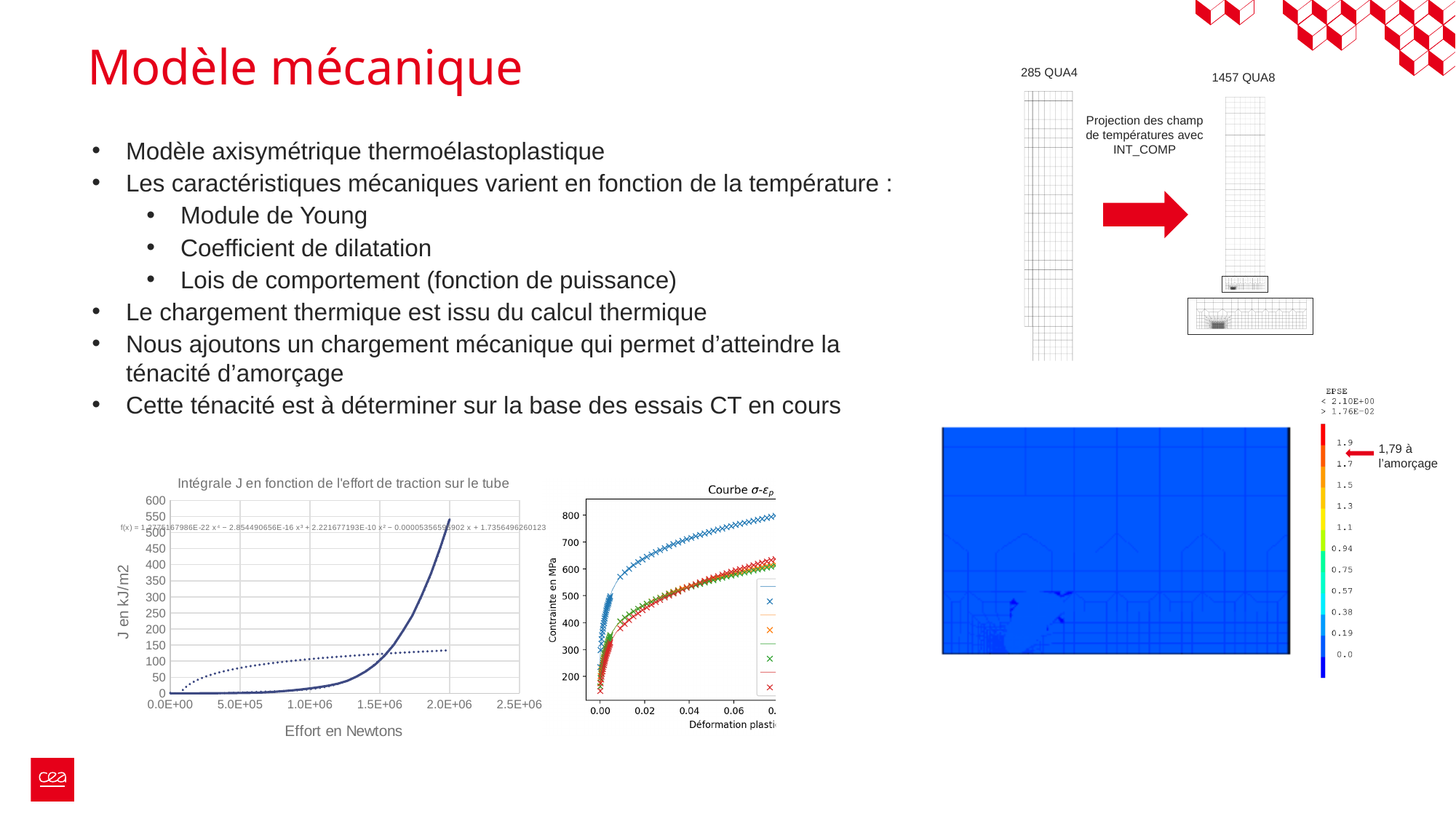
In the chart 'Courbe σ-εp', what is the label of the y axis? Contrainte en MPa In the chart 'Intégrale J en fonction de l'effort de traction sur le tube', what is the label of the x axis? Effort en Newtons What kind of chart is 'Intégrale J en fonction de l'effort de traction sur le tube'? line chart What is the title of the chart on the bottom left of the slide? Intégrale J en fonction de l'effort de traction sur le tube In the chart 'Intégrale J en fonction de l'effort de traction sur le tube', is the value of the dotted curve at 2.0E+06 N greater or less than 150? less In the chart 'Courbe σ-εp', do the stress values rise or fall as the plastic strain increases? rise In the chart 'Courbe σ-εp', is the value of the blue series at the right edge of the plot greater or less than 700 MPa? greater In the chart 'Intégrale J en fonction de l'effort de traction sur le tube', does the solid curve rise or fall as the effort increases? rise In the chart 'Intégrale J en fonction de l'effort de traction sur le tube', is the value of the solid curve at 2.0E+06 N greater or less than 500? greater In the chart 'Intégrale J en fonction de l'effort de traction sur le tube', at 2.0E+06 N, which curve has the larger value, the solid curve or the dotted curve? the solid curve